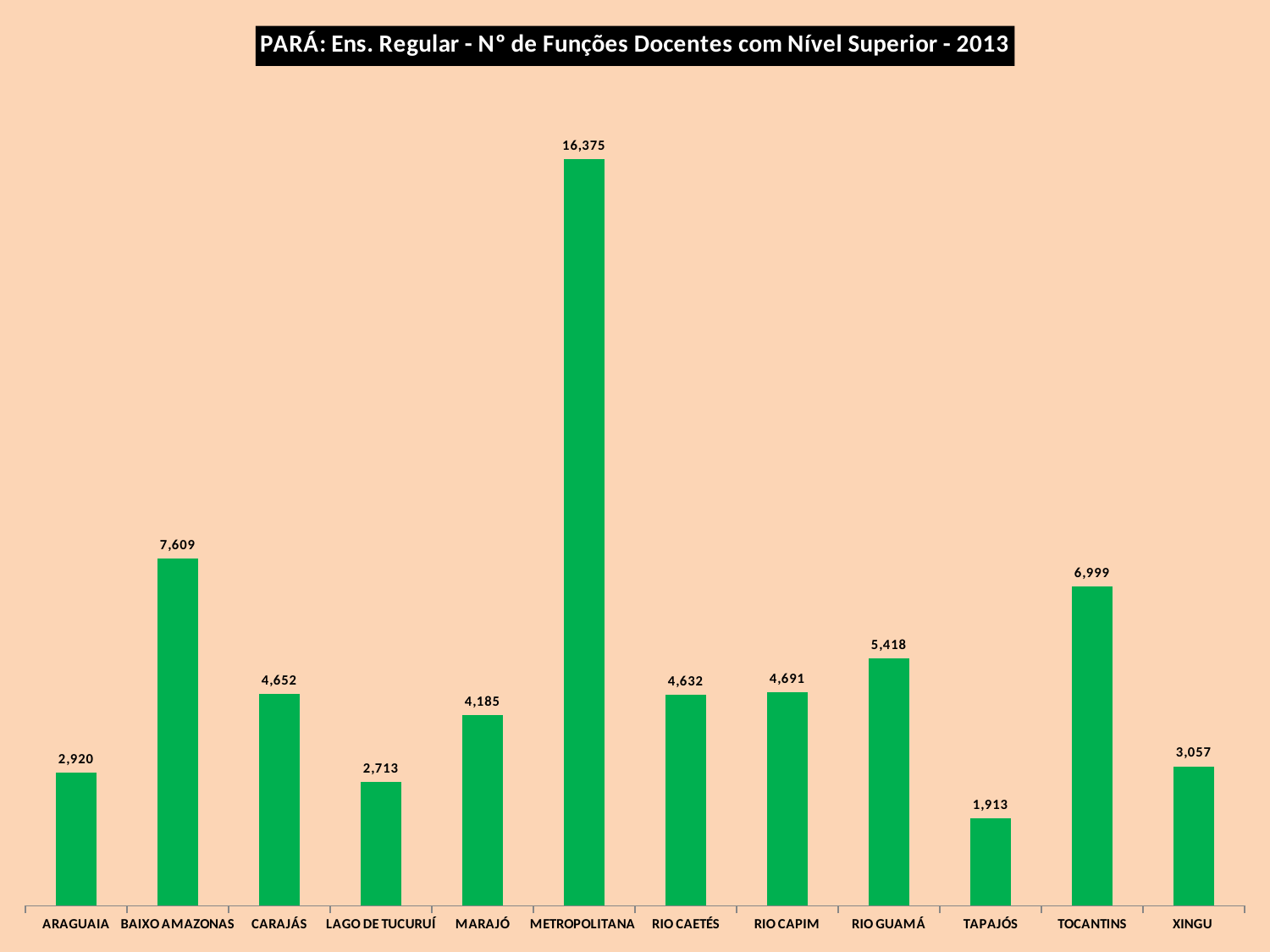
Which is larger, the value for ARAGUAIA or the value for XINGU? XINGU How many categories are shown on the x axis? 12 What is the value for TAPAJÓS? 1,913 What is the difference between the values for BAIXO AMAZONAS and TOCANTINS? 610 What is the value for METROPOLITANA? 16,375 Which category has the lowest value? TAPAJÓS Which category has the highest value? METROPOLITANA What kind of chart is shown on the slide? Bar chart What is the difference between the values for METROPOLITANA and TAPAJÓS? 14,462 Which is larger, the value for RIO GUAMÁ or the value for RIO CAPIM? RIO GUAMÁ What is the value for BAIXO AMAZONAS? 7,609 What is the title of the chart? PARÁ: Ens. Regular - N° de Funções Docentes com Nível Superior - 2013